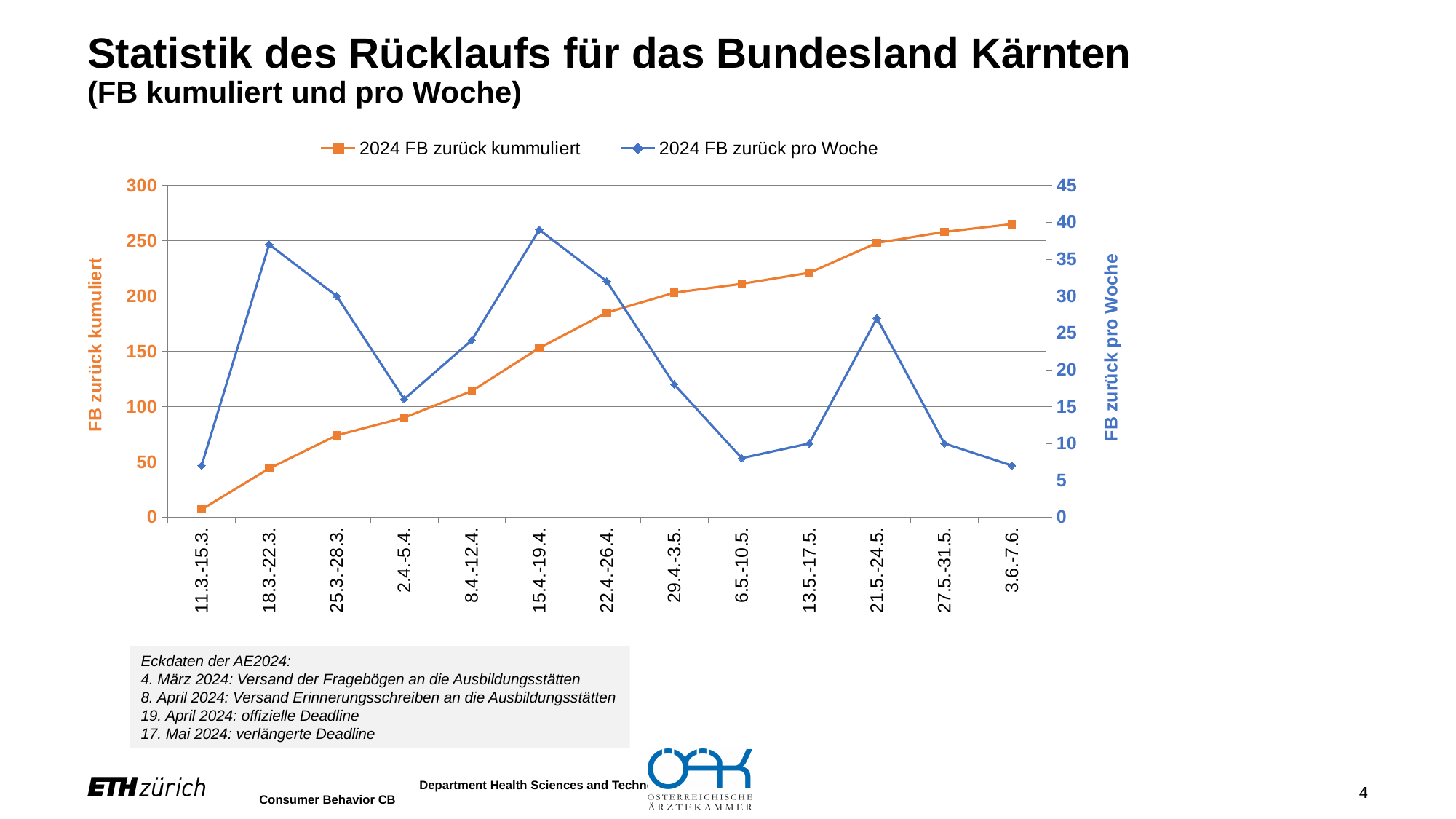
Is the value of 2024 FB zurück pro Woche for 21.5.-24.5. greater or less than 20? greater How many week categories are shown on the x axis? 13 Is the value of 2024 FB zurück kummuliert for 3.6.-7.6. greater or less than 250? greater What kind of chart is shown on the slide? line chart Is the value of 2024 FB zurück kummuliert for 22.4.-26.4. greater or less than 200? less Which week has the highest value for the series 2024 FB zurück kummuliert? 3.6.-7.6. Which week has the lowest value for the series 2024 FB zurück kummuliert? 11.3.-15.3. How many series does the legend list? 2 Which week has the highest value for the series 2024 FB zurück pro Woche? 15.4.-19.4. Does the series 2024 FB zurück kummuliert rise or fall along the x axis? rise For the series 2024 FB zurück pro Woche, which week has the larger value: 18.3.-22.3. or 25.3.-28.3.? 18.3.-22.3.